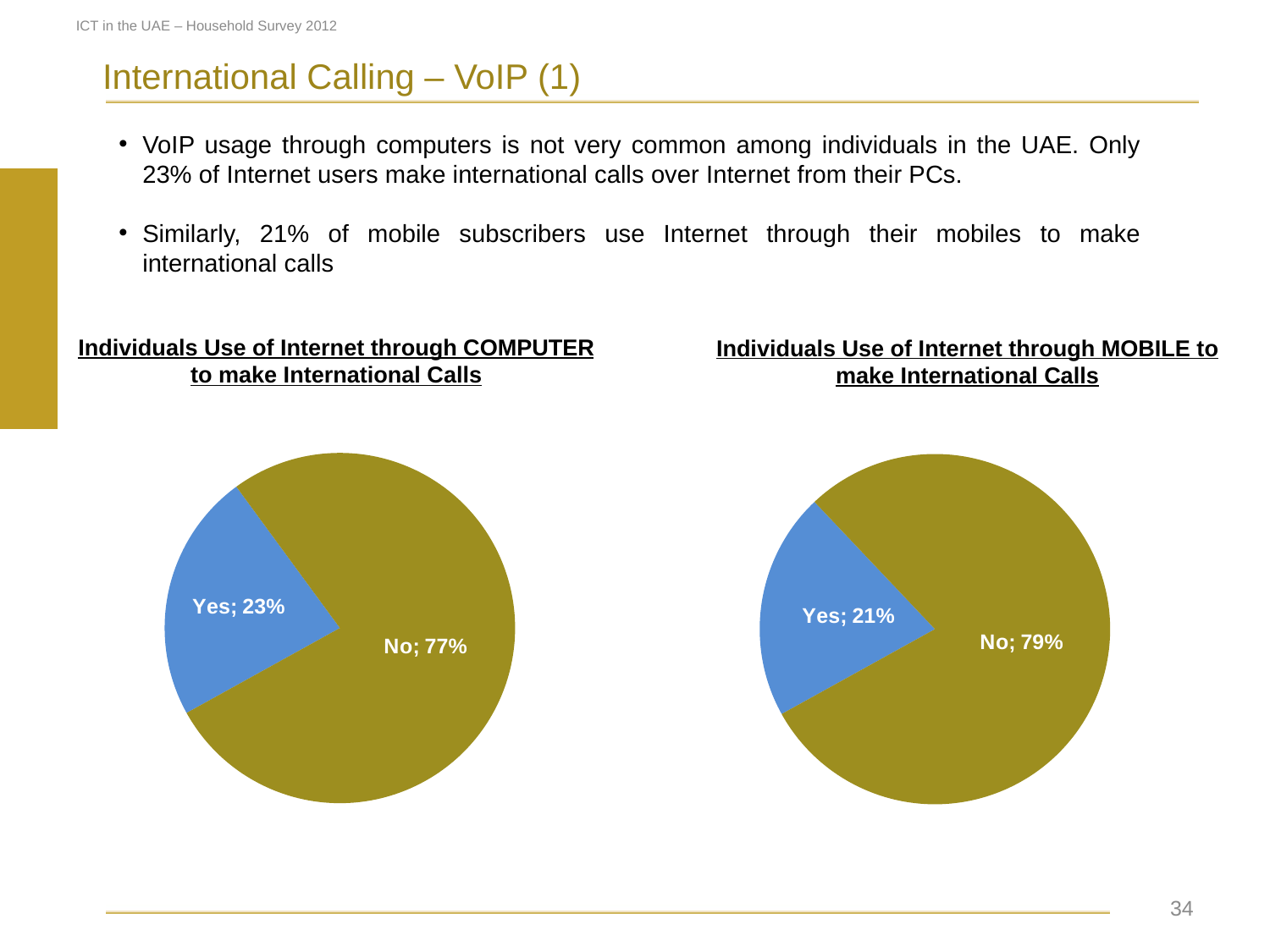
In the right pie chart (Internet through MOBILE to make International Calls), what share of individuals answered Yes? 21% In the right pie chart (Internet through MOBILE to make International Calls), what share of individuals answered No? 79% In the left pie chart (COMPUTER), which category has the largest slice? No Which is larger: the Yes share in the COMPUTER pie chart or the Yes share in the MOBILE pie chart? COMPUTER (23%) In the right pie chart (MOBILE), which category has the smallest slice? Yes In the right pie chart (MOBILE), what is the difference between the No and Yes shares? 58% How many slices does the left pie chart (COMPUTER) have? 2 In the left pie chart (Internet through COMPUTER to make International Calls), what share of individuals answered Yes? 23% In the left pie chart (COMPUTER), what is the difference between the No and Yes shares? 54% In the right pie chart (MOBILE), what colour is the Yes slice? Blue In the left pie chart (Internet through COMPUTER to make International Calls), what share of individuals answered No? 77% What type of chart is used on the right side of the slide (MOBILE)? Pie chart